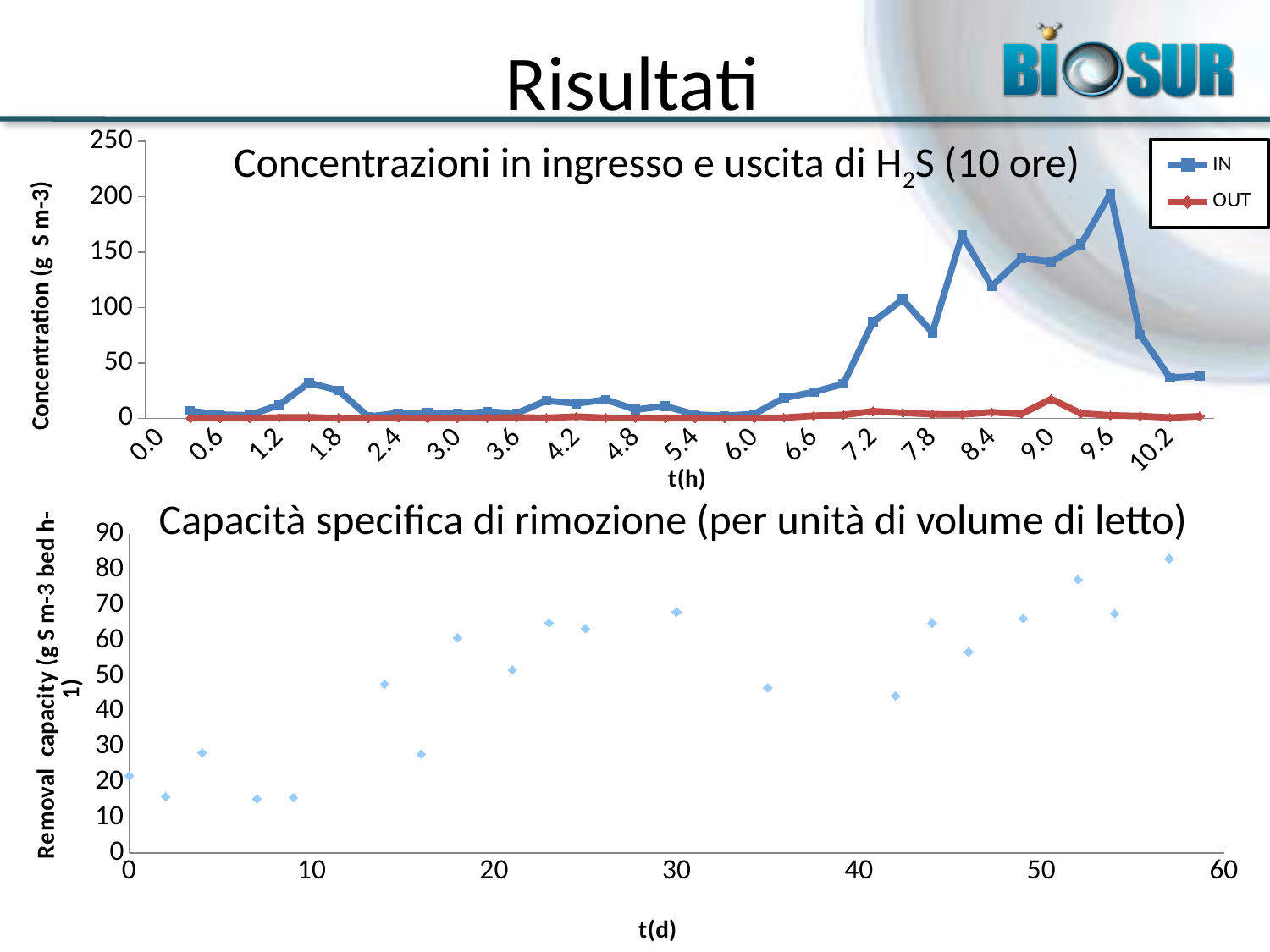
In the top chart, how many series does the legend list? 2 In the bottom chart, is the removal capacity at t = 0 d greater or less than 30? less In the top chart, which series stays lower across the whole time range? OUT In the bottom chart, do the removal capacity values generally rise or fall as t(d) increases? rise What kind of chart is the bottom chart, 'Capacità specifica di rimozione (per unità di volume di letto)'? scatter chart In the top chart, which series is drawn in red? OUT In the top chart, is the highest value of the IN series greater or less than 150? greater What kind of chart is the top chart, 'Concentrazioni in ingresso e uscita di H2S (10 ore)'? line chart In the bottom chart, is the removal capacity at t = 30 d greater or less than 60? greater In the top chart, what are the two series named in the legend? IN and OUT In the top chart, which series has the larger value at t = 7.2 h, IN or OUT? IN In the top chart, does the IN series rise or fall between t = 6.0 h and t = 7.2 h? rise